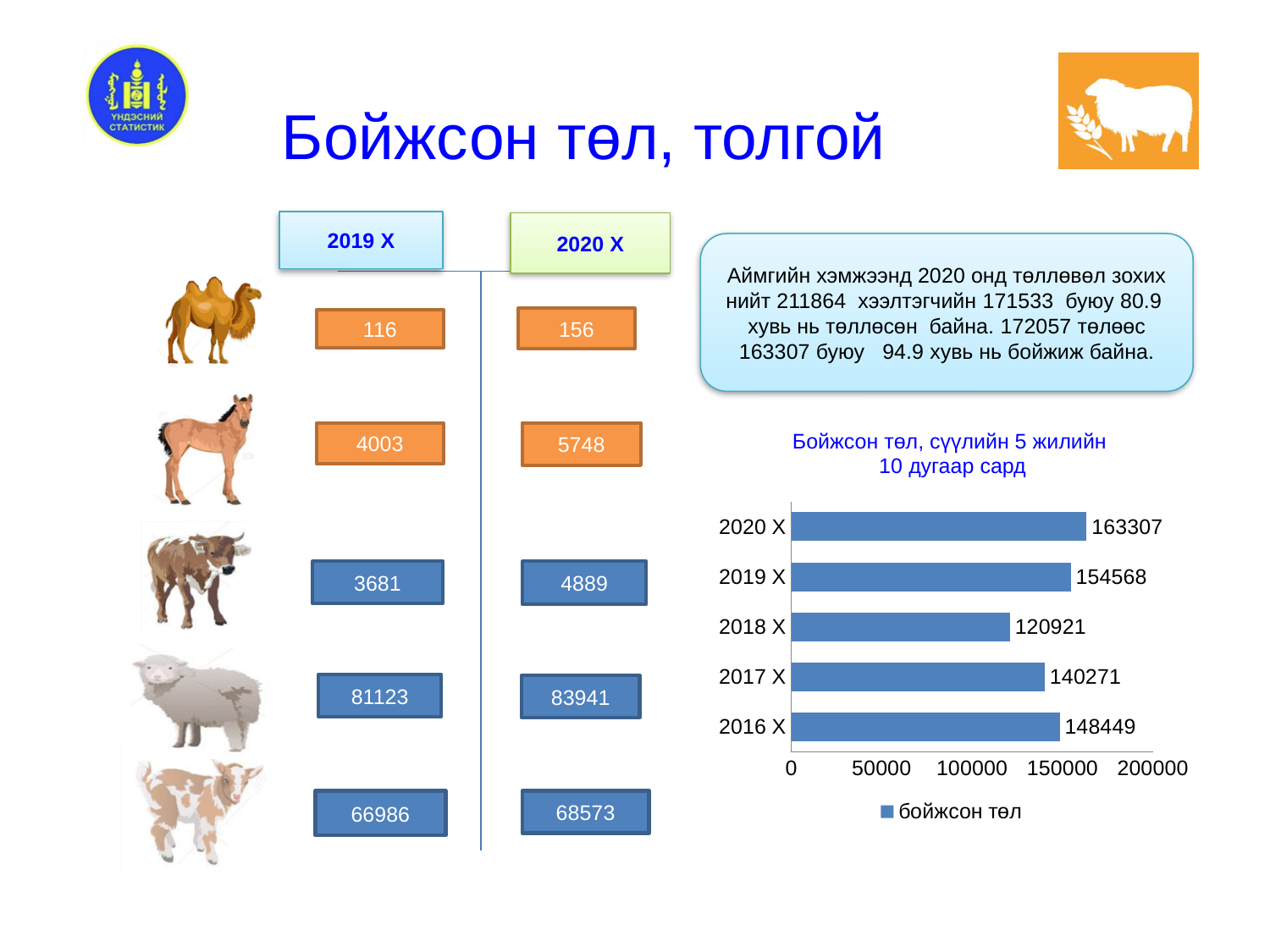
What is the value for 2018 X in the chart? 120921 How many years are shown in the chart? 5 What is the legend entry of the chart? бойжсон төл Which year has the lowest value in the chart? 2018 X What is the value for 2016 X in the chart? 148449 What is the value for 2020 X in the chart? 163307 What type of chart is shown on the slide? bar chart How many series does the chart legend list? 1 Which is larger, the value for 2016 X or the value for 2017 X? 2016 X What is the difference between the values for 2020 X and 2019 X? 8739 Is the value for 2017 X greater or less than 150000? less Which year has the highest value in the chart? 2020 X